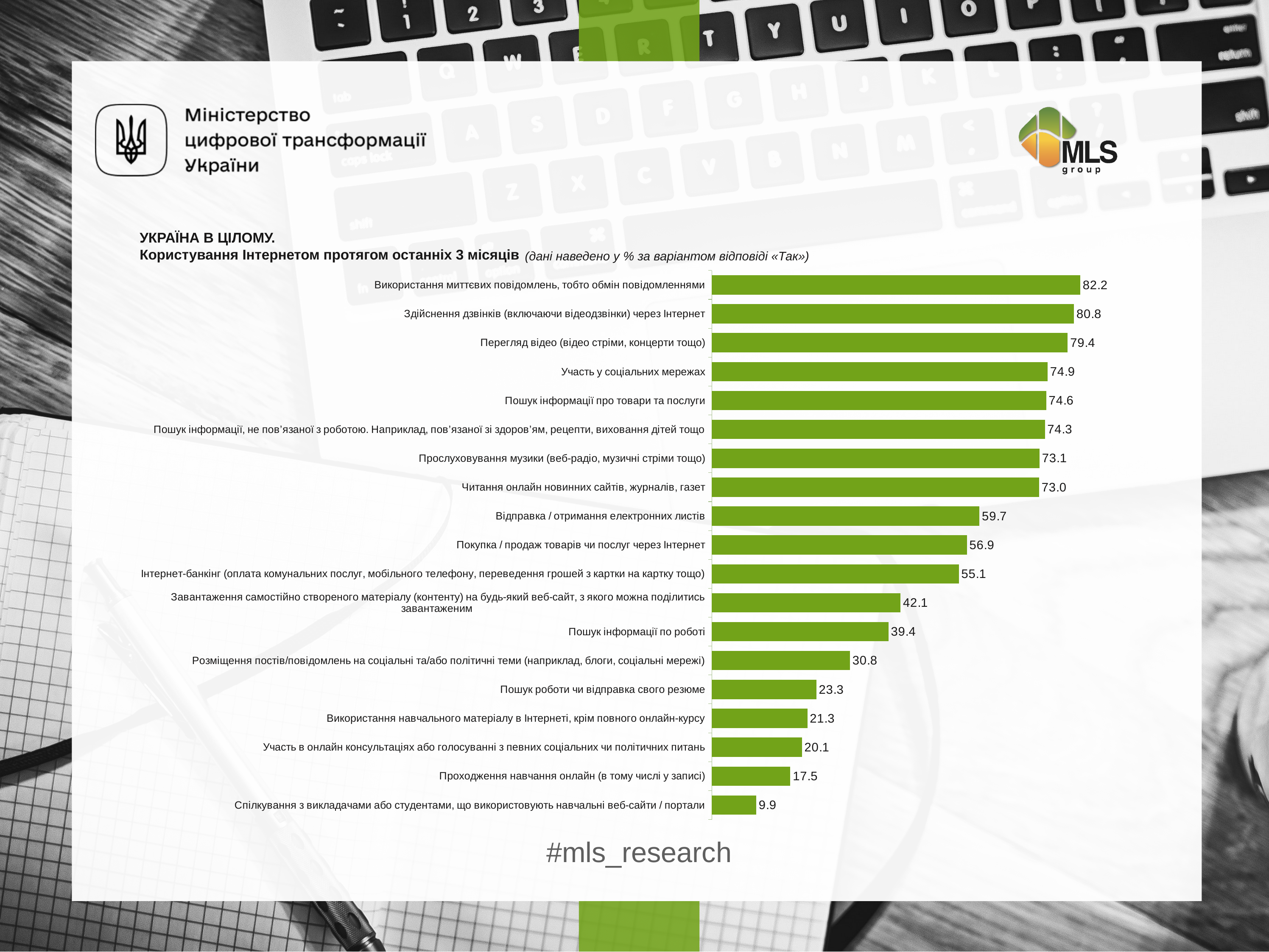
What is the difference between the values for "Пошук інформації по роботі" and "Проходження навчання онлайн (в тому числі у записі)"? 21.9 What value is shown for "Використання миттєвих повідомлень, тобто обмін повідомленнями"? 82.2 What is the difference between the values for "Здійснення дзвінків (включаючи відеодзвінки) через Інтернет" and "Відправка / отримання електронних листів"? 21.1 What value is shown for "Пошук роботи чи відправка свого резюме"? 23.3 Which category has the highest value? Використання миттєвих повідомлень, тобто обмін повідомленнями What kind of chart is shown on the slide? Bar chart How many categories are shown in the chart? 19 What value is shown for "Інтернет-банкінг (оплата комунальних послуг, мобільного телефону, переведення грошей з картки на картку тощо)"? 55.1 Which is larger: the value for "Участь у соціальних мережах" or for "Розміщення постів/повідомлень на соціальні та/або політичні теми (наприклад, блоги, соціальні мережі)"? Участь у соціальних мережах Which category has the lowest value? Спілкування з викладачами або студентами, що використовують навчальні веб-сайти / портали Which is larger: the value for "Покупка / продаж товарів чи послуг через Інтернет" or for "Завантаження самостійно створеного матеріалу (контенту) на будь-який веб-сайт, з якого можна поділитись завантаженим"? Покупка / продаж товарів чи послуг через Інтернет What is the title of the chart? Україна в цілому. Користування Інтернетом протягом останніх 3 місяців